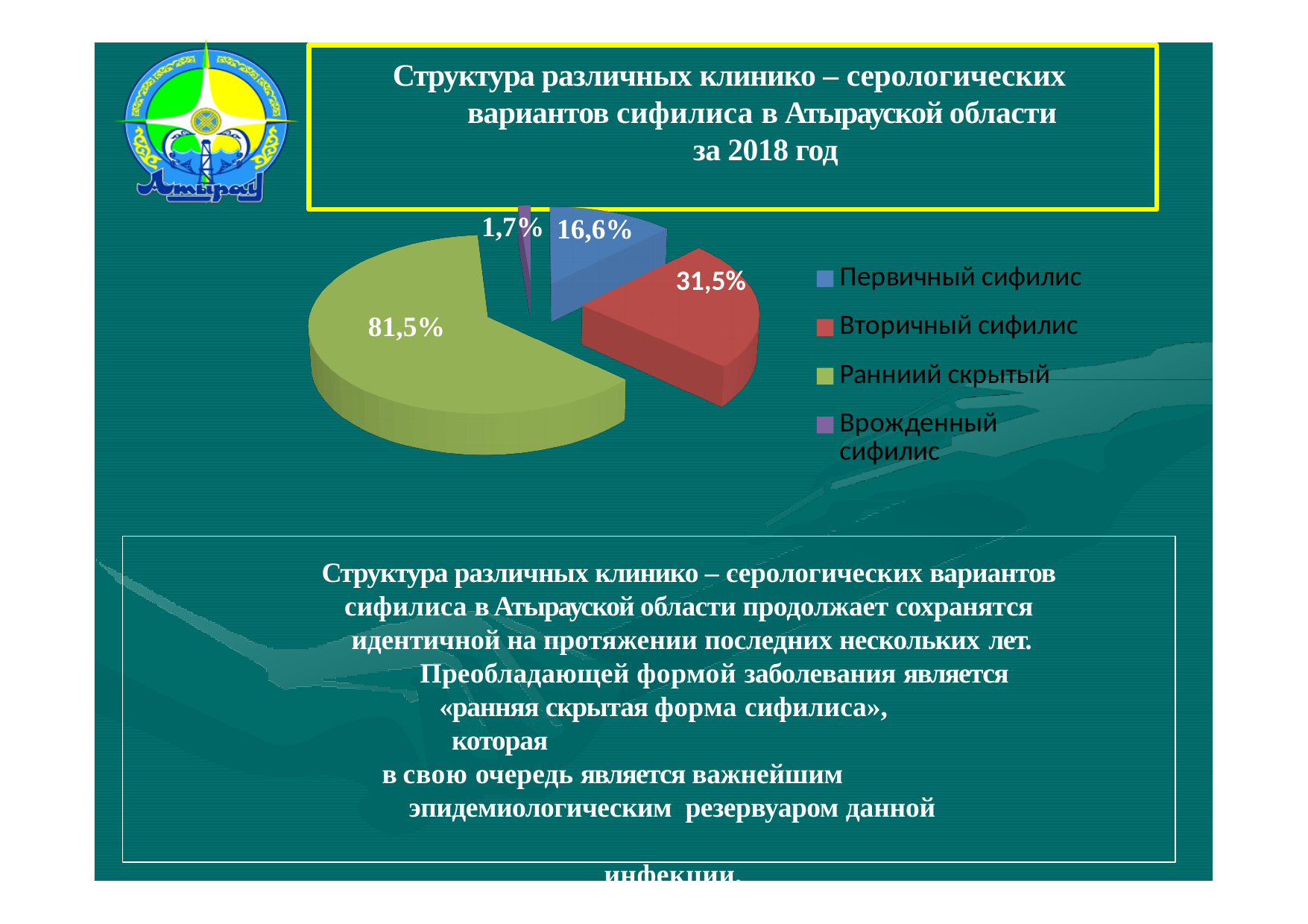
How many categories does the legend list? 4 What percentage is shown for Врожденный сифилис? 1,7% What percentage is shown for Вторичный сифилис? 31,5% What percentage is shown for Первичный сифилис? 16,6% What is the difference in percentage points between Вторичный сифилис and Первичный сифилис? 14,9 Which category has the largest slice of the pie? Ранниий скрытый Which is larger, the slice for Вторичный сифилис or the slice for Первичный сифилис? Вторичный сифилис What kind of chart is shown on the slide? Pie chart What percentage is shown for Ранниий скрытый? 81,5% What is the difference in percentage points between Ранниий скрытый and Вторичный сифилис? 50 What colour is the slice for Ранниий скрытый? Green Which category has the smallest slice of the pie? Врожденный сифилис